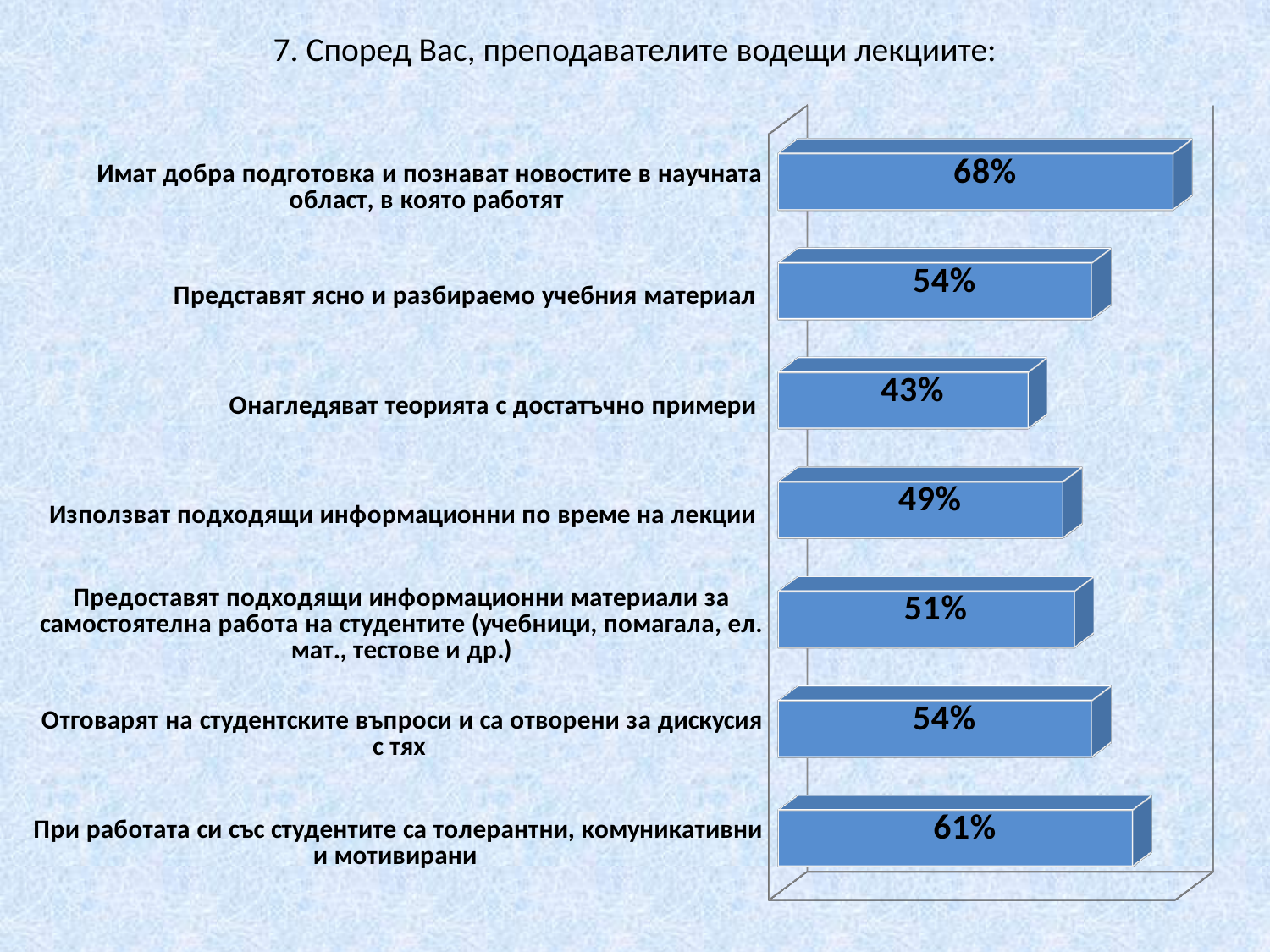
What kind of chart is shown on the slide? Bar chart What value is shown for "При работата си със студентите са толерантни, комуникативни и мотивирани"? 61% What value is shown for "Имат добра подготовка и познават новостите в научната област, в която работят"? 68% How many categories are shown in the chart? 7 Which category has the highest value? Имат добра подготовка и познават новостите в научната област, в която работят What is the title of the slide? 7. Според Вас, преподавателите водещи лекциите: What value is shown for "Онагледяват теорията с достатъчно примери"? 43% Which category has the lowest value? Онагледяват теорията с достатъчно примери What value is shown for "Предоставят подходящи информационни материали за самостоятелна работа на студентите (учебници, помагала, ел. мат., тестове и др.)"? 51% What value is shown for "Използват подходящи информационни по време на лекции"? 49% What is the difference between the values for "Имат добра подготовка и познават новостите в научната област, в която работят" and "Онагледяват теорията с достатъчно примери"? 25% Which is larger: the value for "Представят ясно и разбираемо учебния материал" or the value for "Използват подходящи информационни по време на лекции"? Представят ясно и разбираемо учебния материал